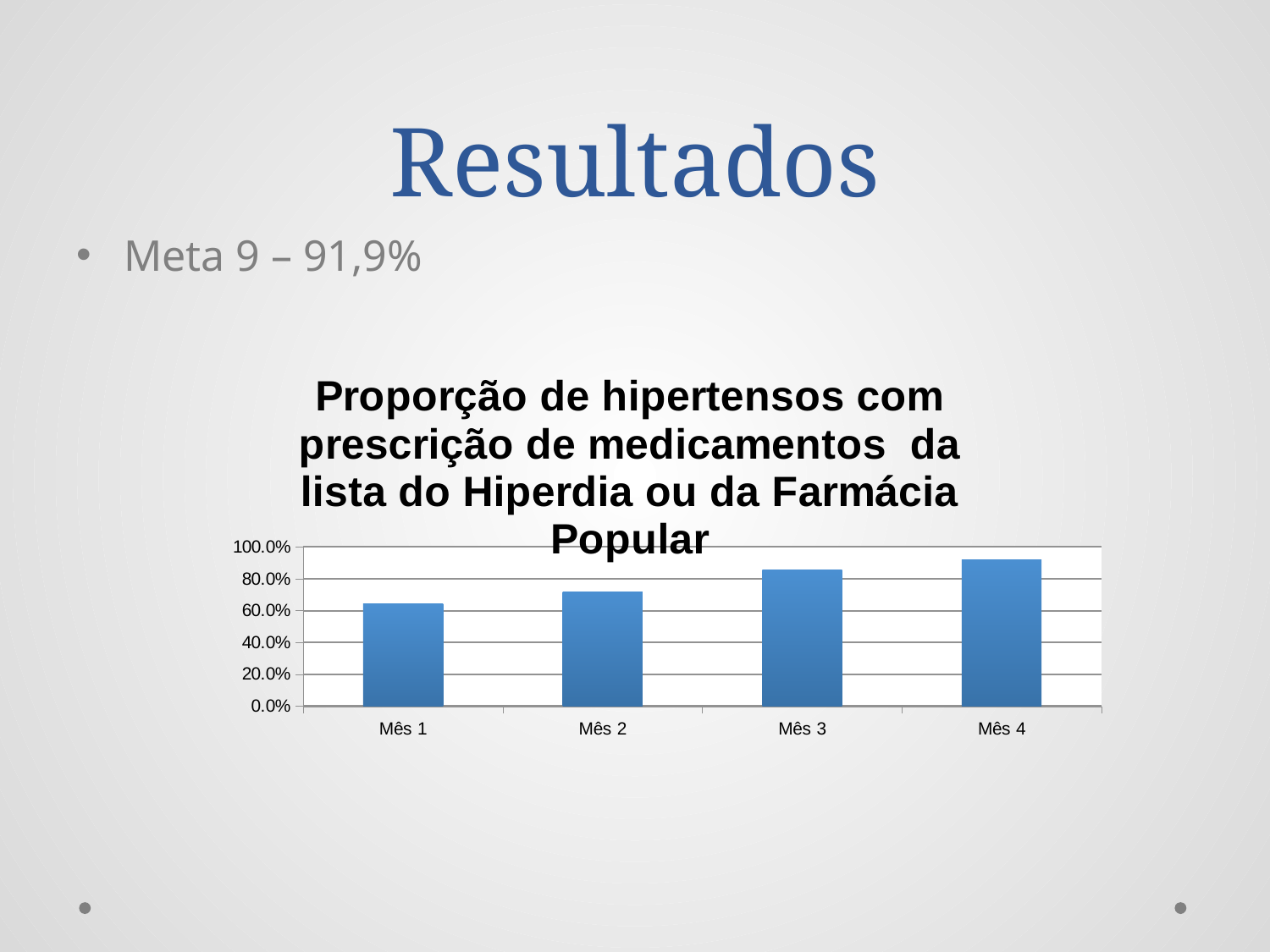
Is the value for Mês 1 greater or less than 80.0%? less What is the title of the chart? Proporção de hipertensos com prescrição de medicamentos da lista do Hiperdia ou da Farmácia Popular Which month has the lowest value in the chart? Mês 1 Is the value for Mês 2 greater or less than 80.0%? less Do the values rise or fall from Mês 1 to Mês 4? rise Is the value for Mês 2 greater or less than 60.0%? greater How many categories (months) are shown on the x axis of the chart? 4 Which is larger, the value for Mês 2 or the value for Mês 3? Mês 3 Which month has the highest value in the chart? Mês 4 What kind of chart is shown on the slide? bar chart